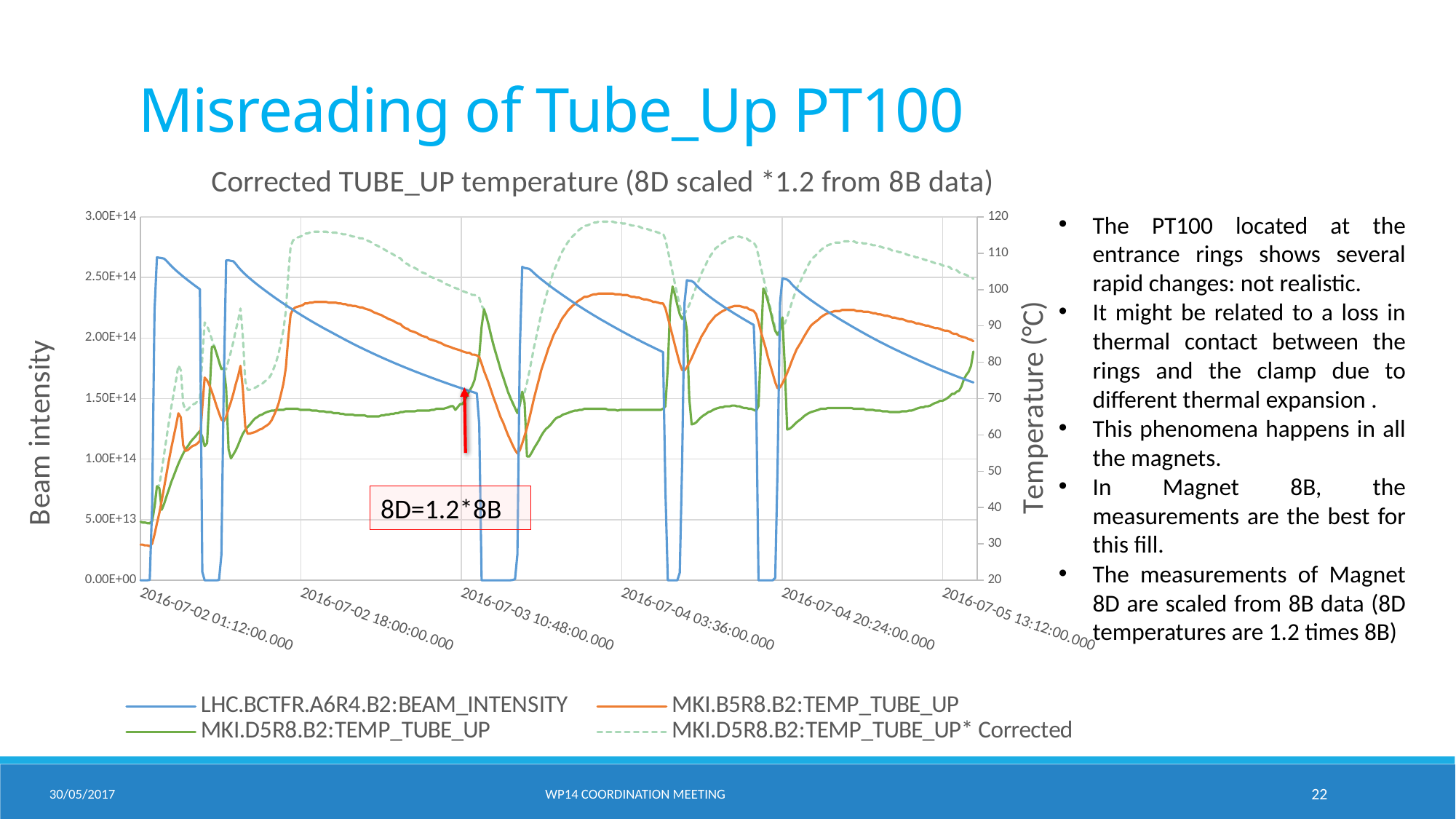
What text is written in the annotation box pointed to by the red arrow? 8D=1.2*8B Which series reaches a higher peak temperature: MKI.D5R8.B2:TEMP_TUBE_UP* Corrected or MKI.B5R8.B2:TEMP_TUBE_UP? MKI.D5R8.B2:TEMP_TUBE_UP* Corrected Between 2016-07-02 18:00:00.000 and 2016-07-03 10:48:00.000, does the LHC.BCTFR.A6R4.B2:BEAM_INTENSITY series rise or fall? fall Is the peak temperature of MKI.B5R8.B2:TEMP_TUBE_UP greater or less than 90? greater What is the title of the chart? Corrected TUBE_UP temperature (8D scaled *1.2 from 8B data) Is the peak temperature of MKI.D5R8.B2:TEMP_TUBE_UP* Corrected greater or less than 110? greater What is the lowest value the LHC.BCTFR.A6R4.B2:BEAM_INTENSITY series drops to between fills? 0.00E+00 Is the highest value reached by LHC.BCTFR.A6R4.B2:BEAM_INTENSITY greater or less than 2.50E+14? greater How many series does the chart legend list? 4 What kind of chart is shown on the slide? line chart Between 2016-07-02 18:00:00.000 and 2016-07-03 10:48:00.000, does the MKI.B5R8.B2:TEMP_TUBE_UP series rise or fall? fall